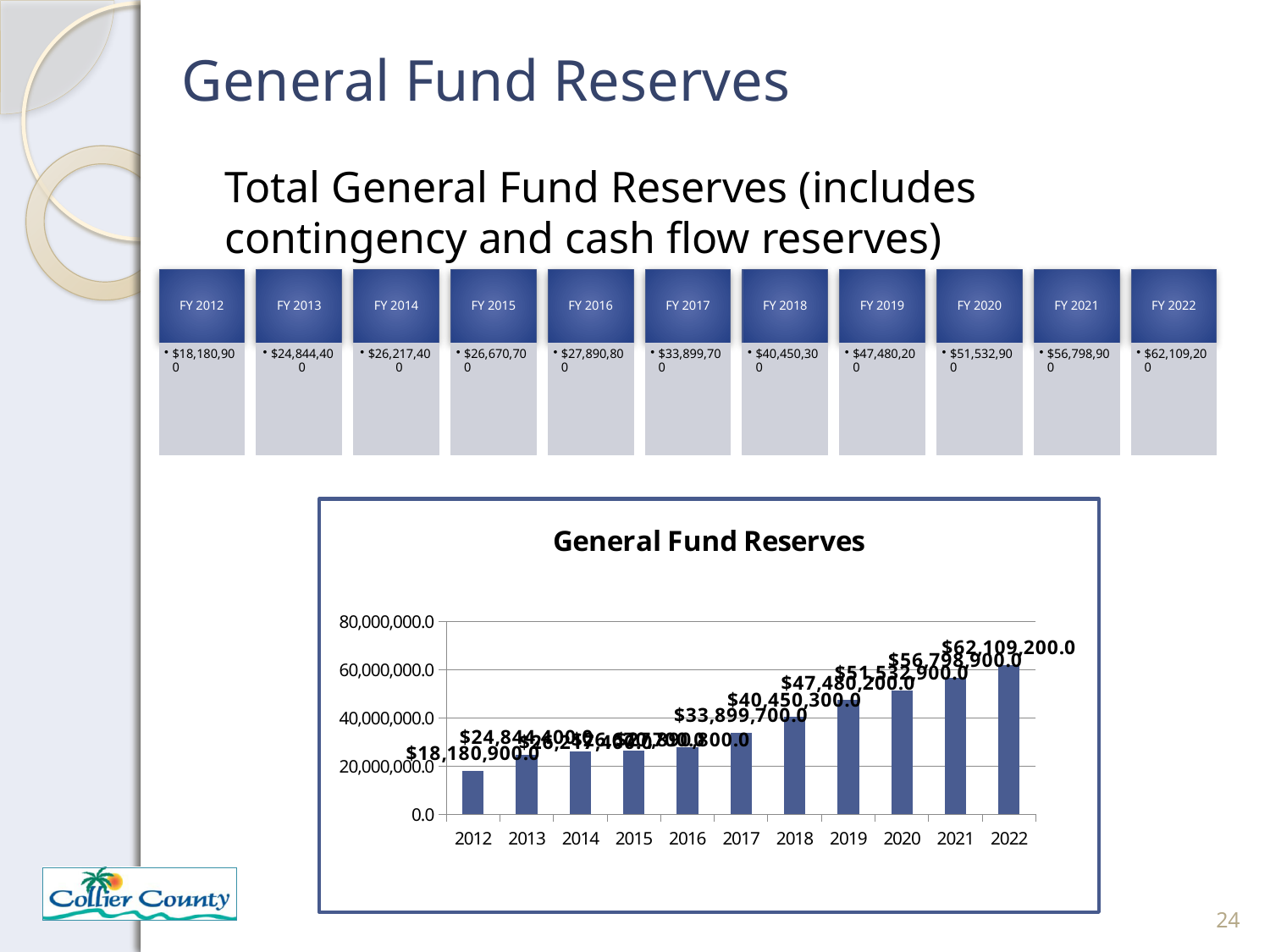
What is the value for 2020 in the General Fund Reserves chart? $51,532,900.0 What is the difference between the 2021 and 2020 values in the General Fund Reserves chart? $5,266,000.0 In the General Fund Reserves chart, which year has the larger value, 2017 or 2018? 2018 Do the values in the General Fund Reserves chart rise or fall from 2012 to 2022? rise What is the value for 2022 in the General Fund Reserves chart? $62,109,200.0 Which year has the highest General Fund Reserves in the chart? 2022 In the General Fund Reserves chart, is the value for 2015 greater or less than 40,000,000.0? less How many years are shown on the x axis of the General Fund Reserves chart? 11 Which year has the lowest General Fund Reserves in the chart? 2012 What kind of chart is the General Fund Reserves chart? bar chart What is the difference between the 2022 and 2012 values in the General Fund Reserves chart? $43,928,300.0 What is the value for 2012 in the General Fund Reserves chart? $18,180,900.0